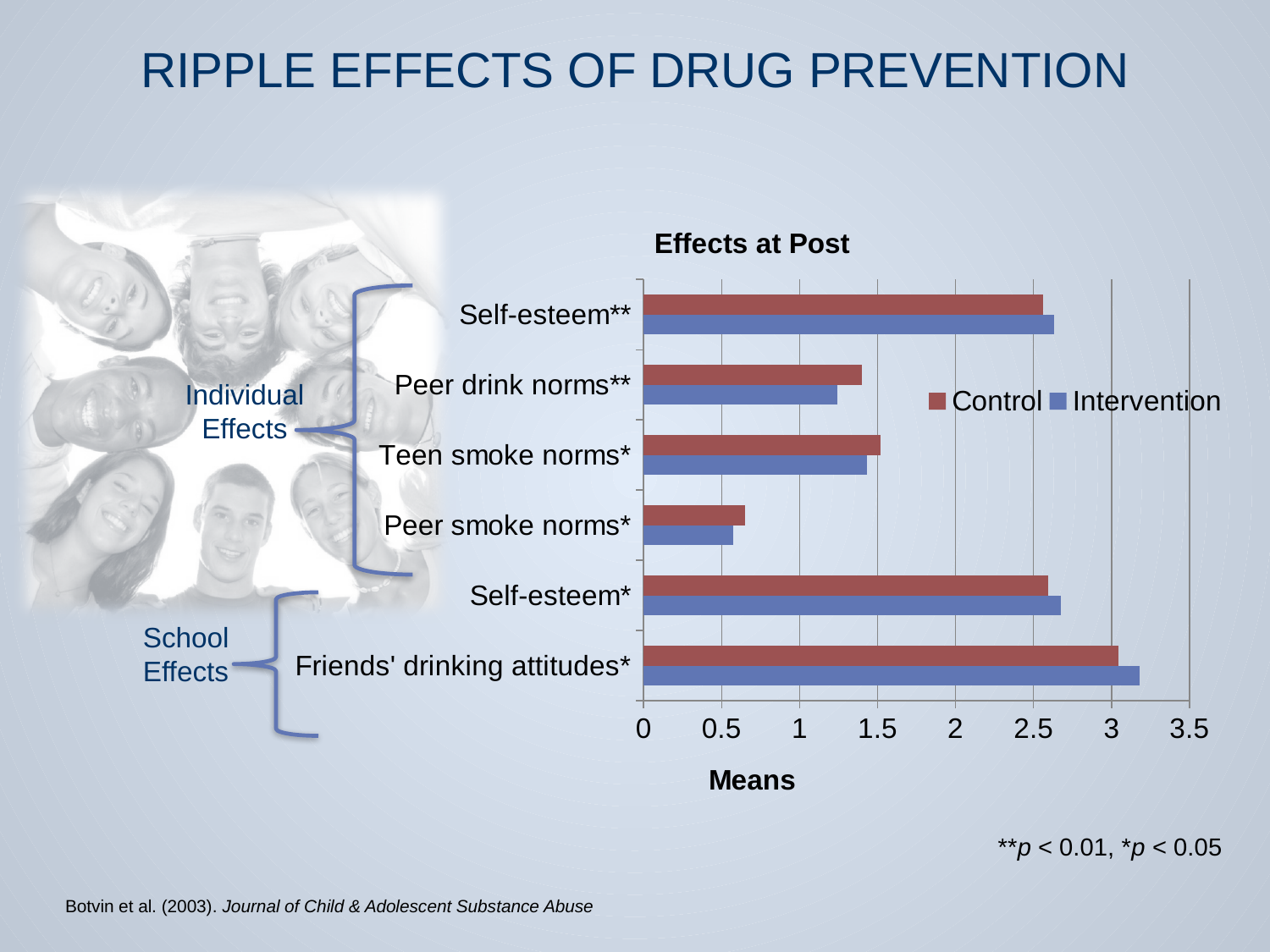
What kind of chart is shown on the slide? bar chart How many categories are plotted on the chart? 6 For Friends' drinking attitudes*, which is larger: the Control value or the Intervention value? Intervention What is the title of the chart? Effects at Post For Peer drink norms**, which is larger: the Control value or the Intervention value? Control What is the label on the horizontal axis of the chart? Means Is the Intervention value for Peer smoke norms* greater or less than 1? less How many series does the legend of the chart list? 2 Which category has the highest Intervention value? Friends' drinking attitudes* Which category has the lowest Control value? Peer smoke norms*